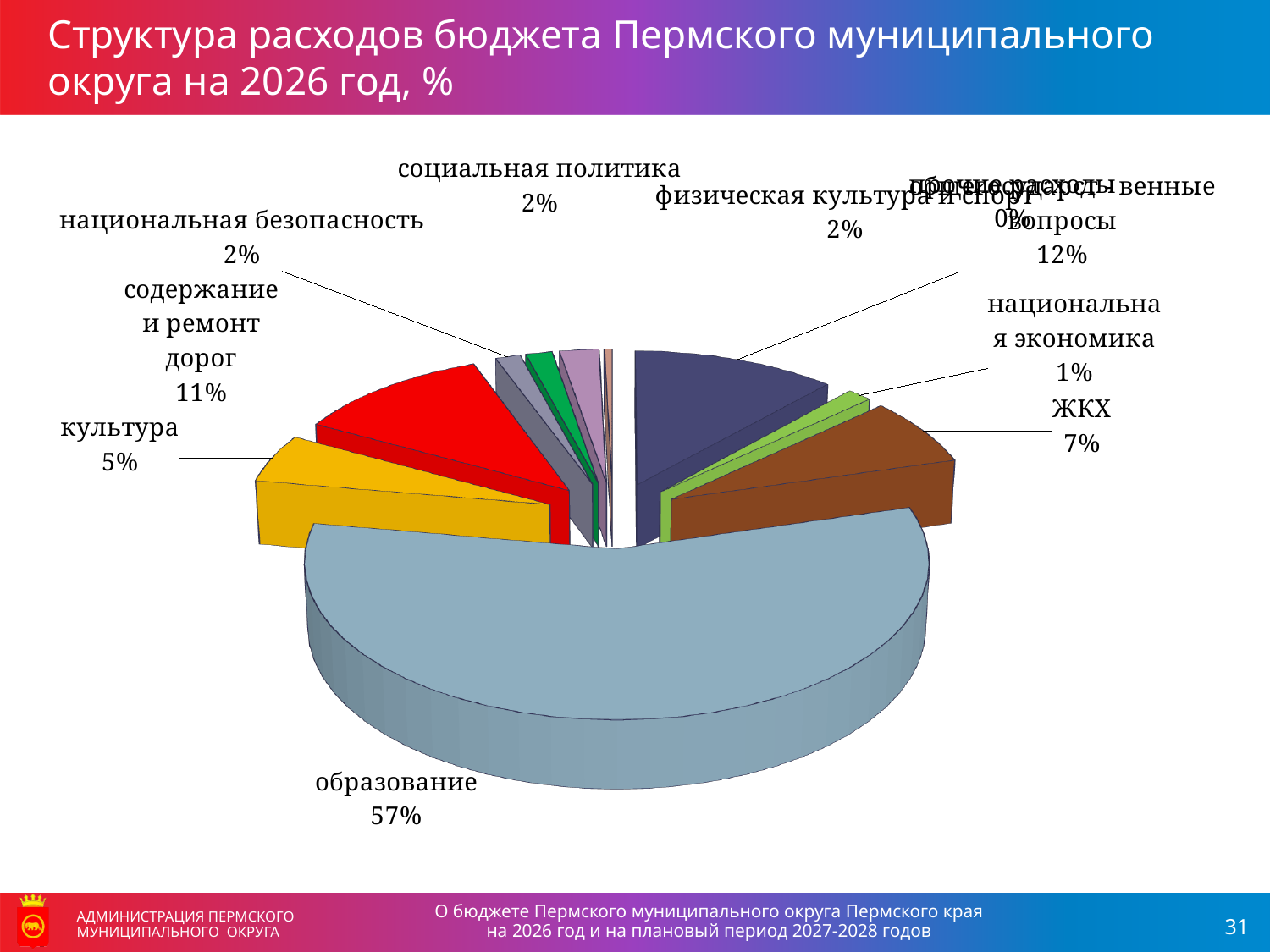
What share of the budget expenditure goes to образование? 57% What percentage is shown for ЖКХ? 7% What percentage is shown for национальная экономика? 1% Which is larger, the share for содержание и ремонт дорог or the share for ЖКХ? содержание и ремонт дорог Which category has the largest share of the pie? образование What percentage is shown for культура? 5% What kind of chart is shown on the slide? pie chart What percentage is shown for содержание и ремонт дорог? 11% By how many percentage points does образование exceed содержание и ремонт дорог? 46% Which is larger, the share for ЖКХ or the share for культура? ЖКХ What is the title of the chart on the slide? Структура расходов бюджета Пермского муниципального округа на 2026 год, % What percentage is shown for социальная политика? 2%